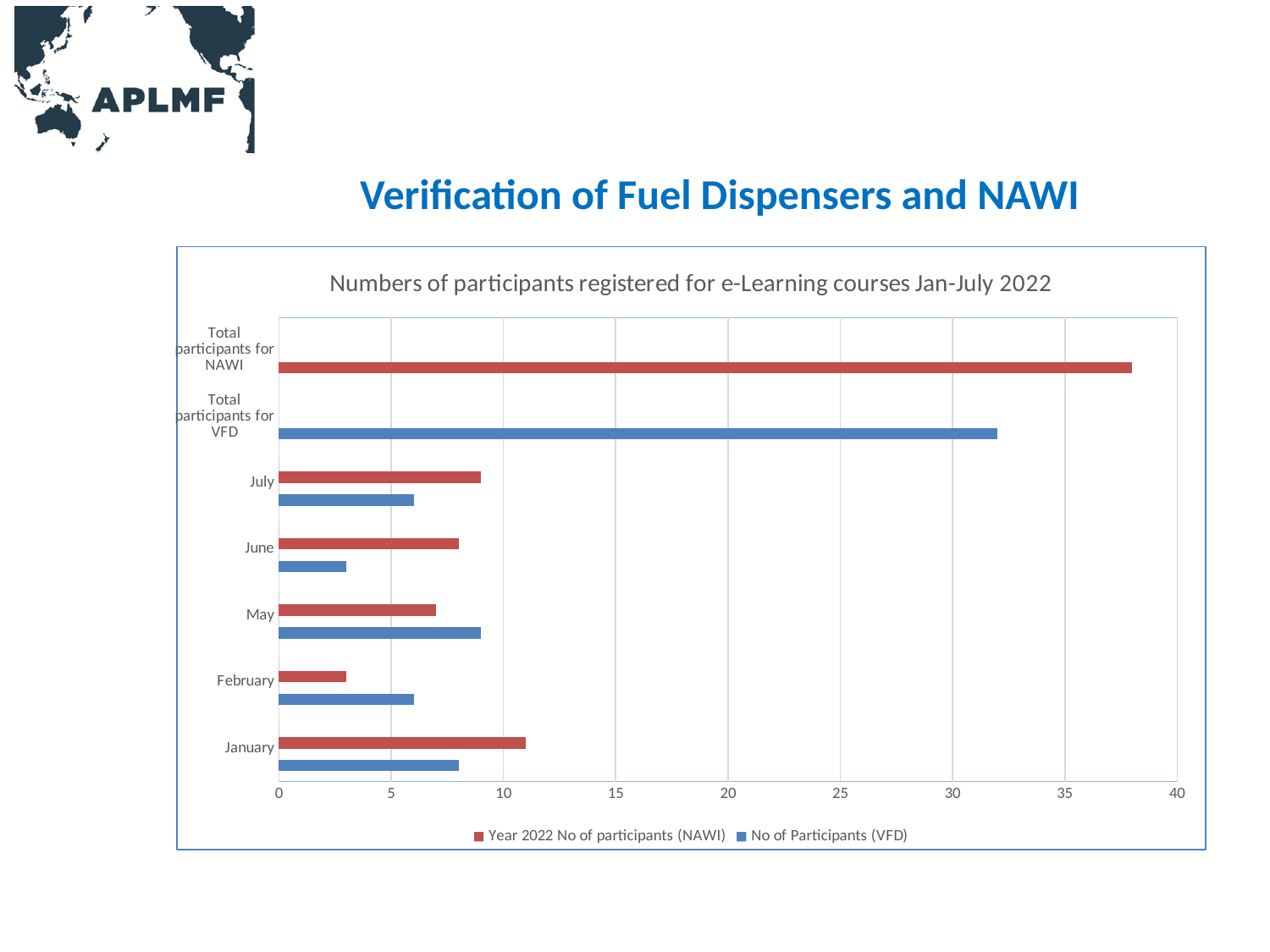
Is the value for Total participants for NAWI greater or less than 35? greater For May, which series has the larger value: Year 2022 No of participants (NAWI) or No of Participants (VFD)? No of Participants (VFD) How many series does the chart legend list? 2 How many categories are shown on the vertical axis of the chart? 7 Is the Year 2022 No of participants (NAWI) value for February greater or less than 5? less Is the No of Participants (VFD) value for June greater or less than 5? less For January, which series has the larger value: Year 2022 No of participants (NAWI) or No of Participants (VFD)? Year 2022 No of participants (NAWI) What is the title of the chart? Numbers of participants registered for e-Learning courses Jan-July 2022 What kind of chart is shown on the slide? bar chart Among the months shown, which month has the highest Year 2022 No of participants (NAWI) value? January